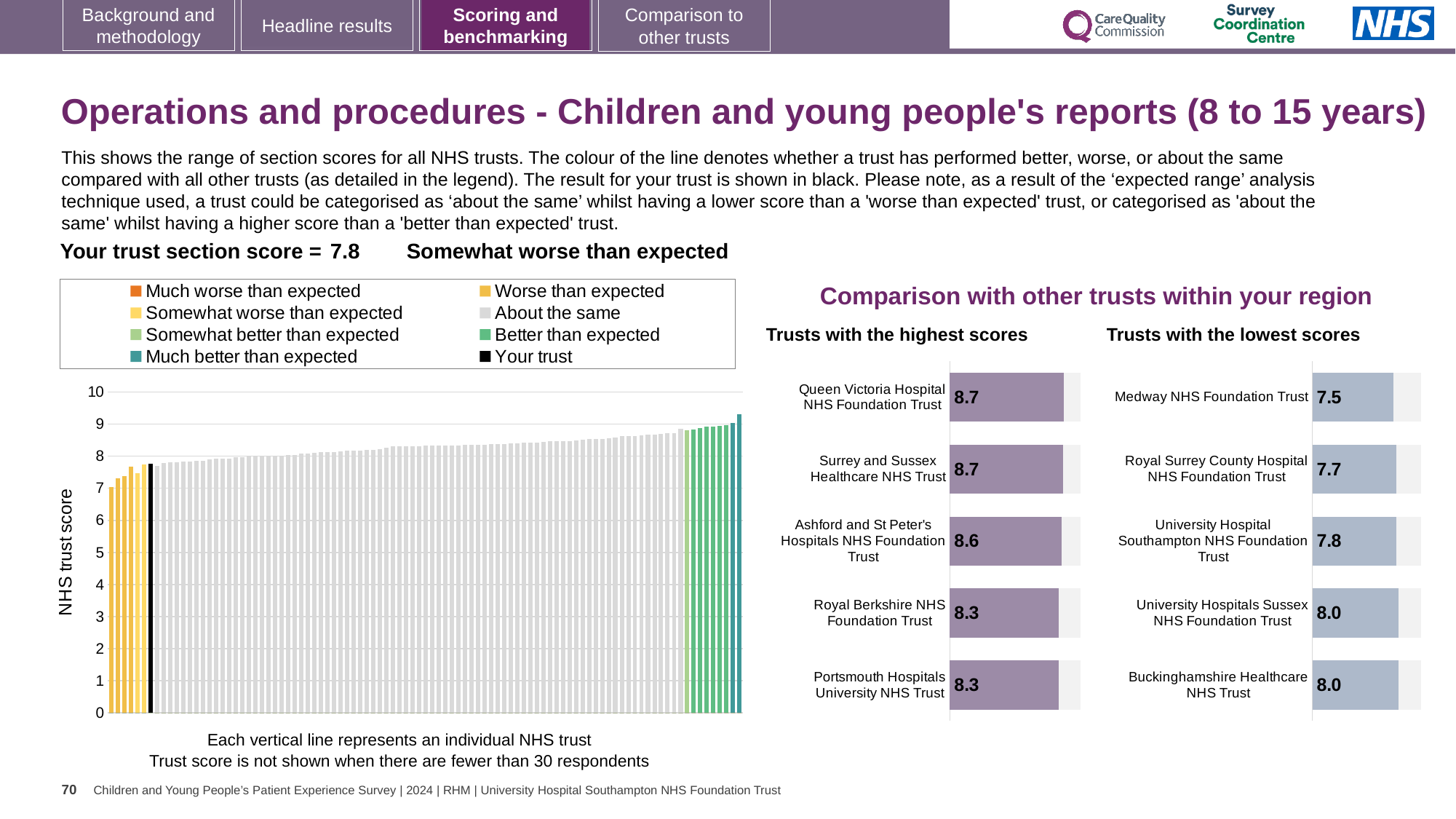
In the 'Trusts with the lowest scores' chart, which trust has the lowest score? Medway NHS Foundation Trust In the 'Trusts with the highest scores' chart, what is the value for Queen Victoria Hospital NHS Foundation Trust? 8.7 In the 'Trusts with the lowest scores' chart, which is larger: the value for Medway NHS Foundation Trust or the value for University Hospitals Sussex NHS Foundation Trust? University Hospitals Sussex NHS Foundation Trust In the 'Trusts with the highest scores' chart, what is the difference between Queen Victoria Hospital NHS Foundation Trust and Portsmouth Hospitals University NHS Trust? 0.4 In the 'Trusts with the highest scores' chart, what is the value for Royal Berkshire NHS Foundation Trust? 8.3 What is the trust section score shown for your trust on this slide? 7.8 In the large chart on the left, do the bar heights rise or fall from left to right? rise What kind of chart is the large chart on the left with the y axis labelled 'NHS trust score'? bar chart In the large chart on the left, what colour is the bar for 'Your trust'? black How many entries does the legend above the large chart on the left list? 8 In the 'Trusts with the highest scores' chart, how many trusts are shown? 5 In the 'Trusts with the lowest scores' chart, what is the value for Royal Surrey County Hospital NHS Foundation Trust? 7.7